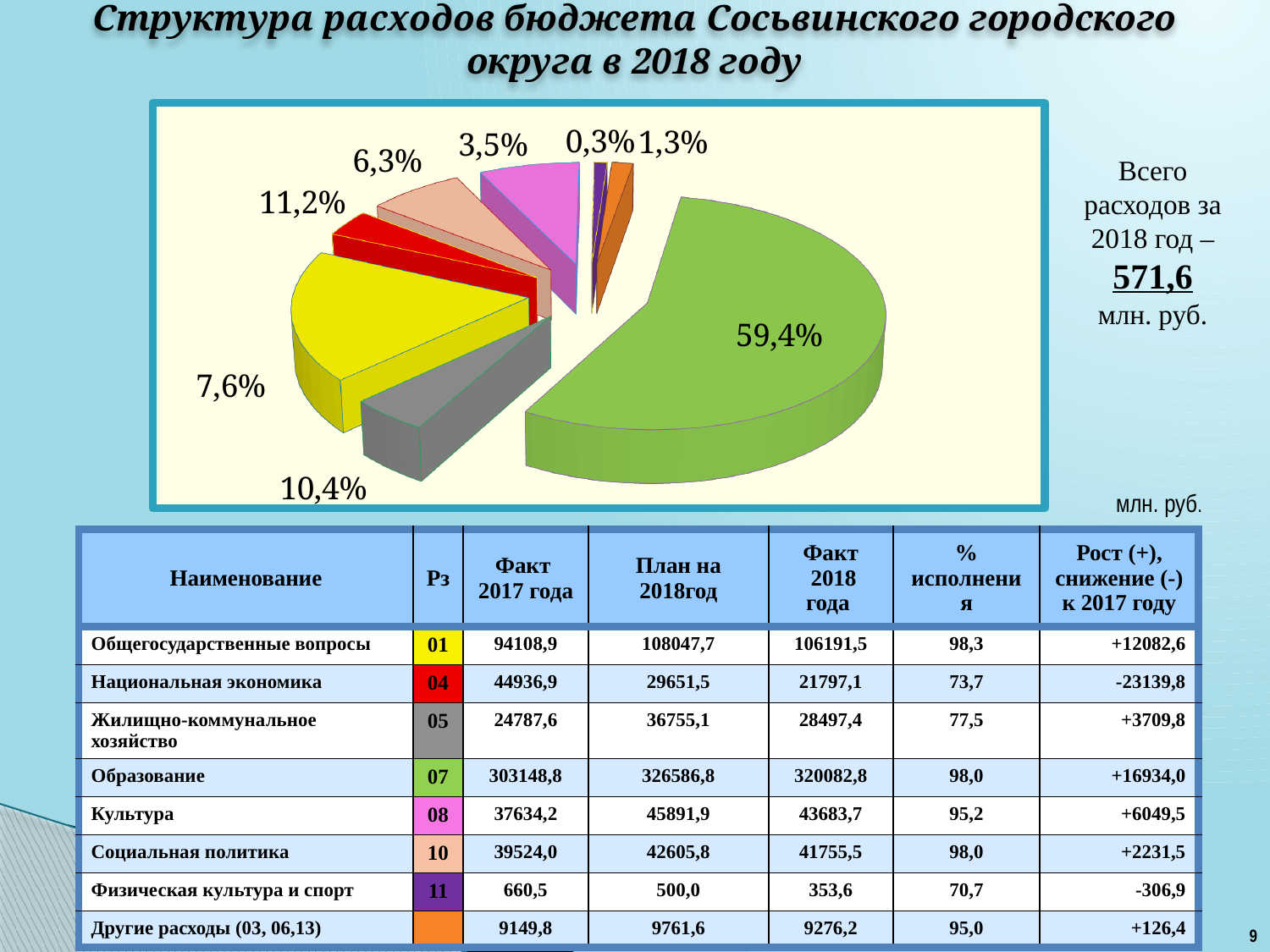
What percentage is shown for the green slice of the pie chart? 59,4% By how many percentage points does the largest slice (59,4%) exceed the red slice (11,2%)? 48,2 How many slices does the pie chart have? 8 What percentage is shown for the red slice of the pie chart? 11,2% What is the difference between the 6,3% slice and the 3,5% slice? 2,8 What percentage is shown for the grey slice of the pie chart? 10,4% What is the value of the smallest slice in the pie chart? 0,3% What total expenditure for 2018 is stated next to the pie chart? 571,6 млн. руб. What percentage is shown for the yellow slice of the pie chart? 7,6% What kind of chart is shown on the slide? pie chart What is the value of the largest slice in the pie chart? 59,4%